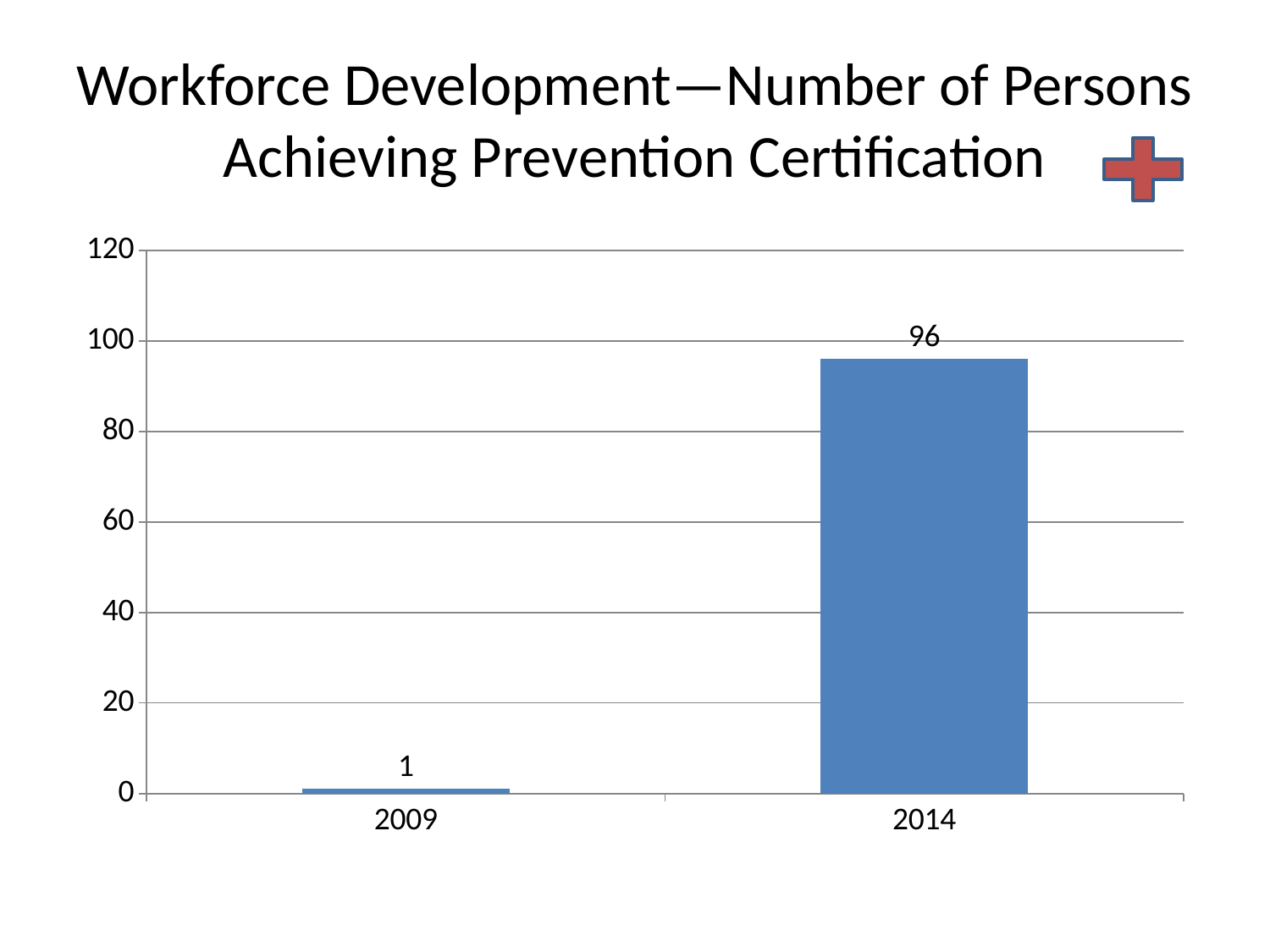
What is the difference between the 2014 and 2009 values? 95 Which is larger, the value for 2009 or the value for 2014? 2014 Is the value for 2014 greater or less than 80? greater What is the number of persons achieving prevention certification in 2014? 96 What is the maximum value shown on the vertical axis? 120 Which year has the highest number of persons achieving prevention certification? 2014 Which year has the lowest number of persons achieving prevention certification? 2009 Is the value for 2009 greater or less than 20? less What kind of chart is shown on the slide? bar chart Do the values rise or fall from 2009 to 2014? rise What is the number of persons achieving prevention certification in 2009? 1 How many years are shown on the chart? 2